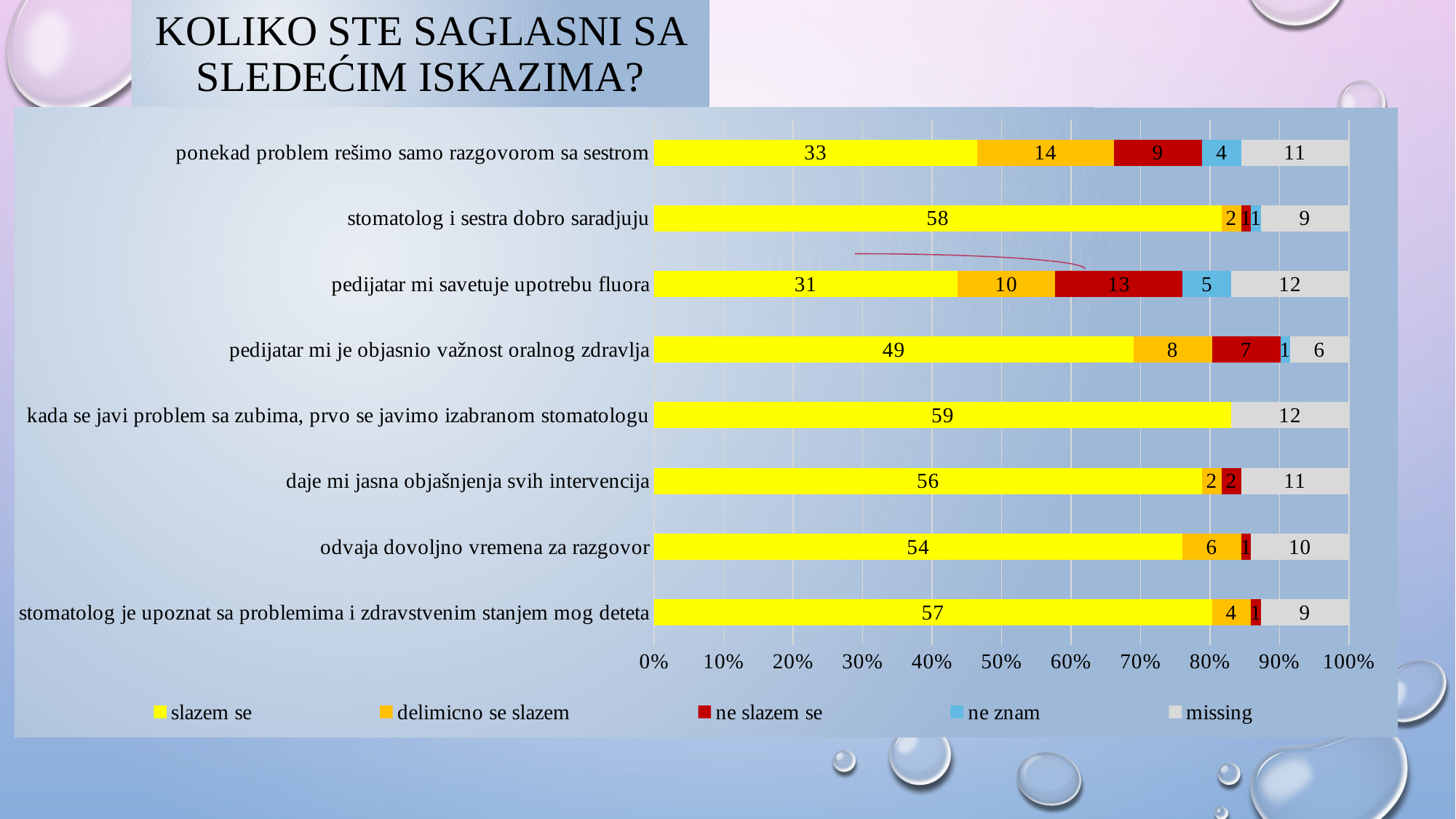
Which statement has the lowest "slazem se" value? pedijatar mi savetuje upotrebu fluora What is the "missing" value for "kada se javi problem sa zubima, prvo se javimo izabranom stomatologu"? 12 What is the difference between the "slazem se" values for "stomatolog i sestra dobro saradjuju" and "pedijatar mi je objasnio važnost oralnog zdravlja"? 9 What is the total of all segments in the bar for "ponekad problem rešimo samo razgovorom sa sestrom"? 71 How many statements (categories) are shown in the chart? 8 What kind of chart is shown on the slide? Stacked bar chart What is the value of "delimicno se slazem" for "odvaja dovoljno vremena za razgovor"? 6 What is the value of "slazem se" for "pedijatar mi savetuje upotrebu fluora"? 31 What is the value of "ne slazem se" for "ponekad problem rešimo samo razgovorom sa sestrom"? 9 Which statement has the highest "slazem se" value? kada se javi problem sa zubima, prvo se javimo izabranom stomatologu How many series does the legend list? 5 Which is larger: the "ne slazem se" value for "pedijatar mi savetuje upotrebu fluora" or for "pedijatar mi je objasnio važnost oralnog zdravlja"? pedijatar mi savetuje upotrebu fluora